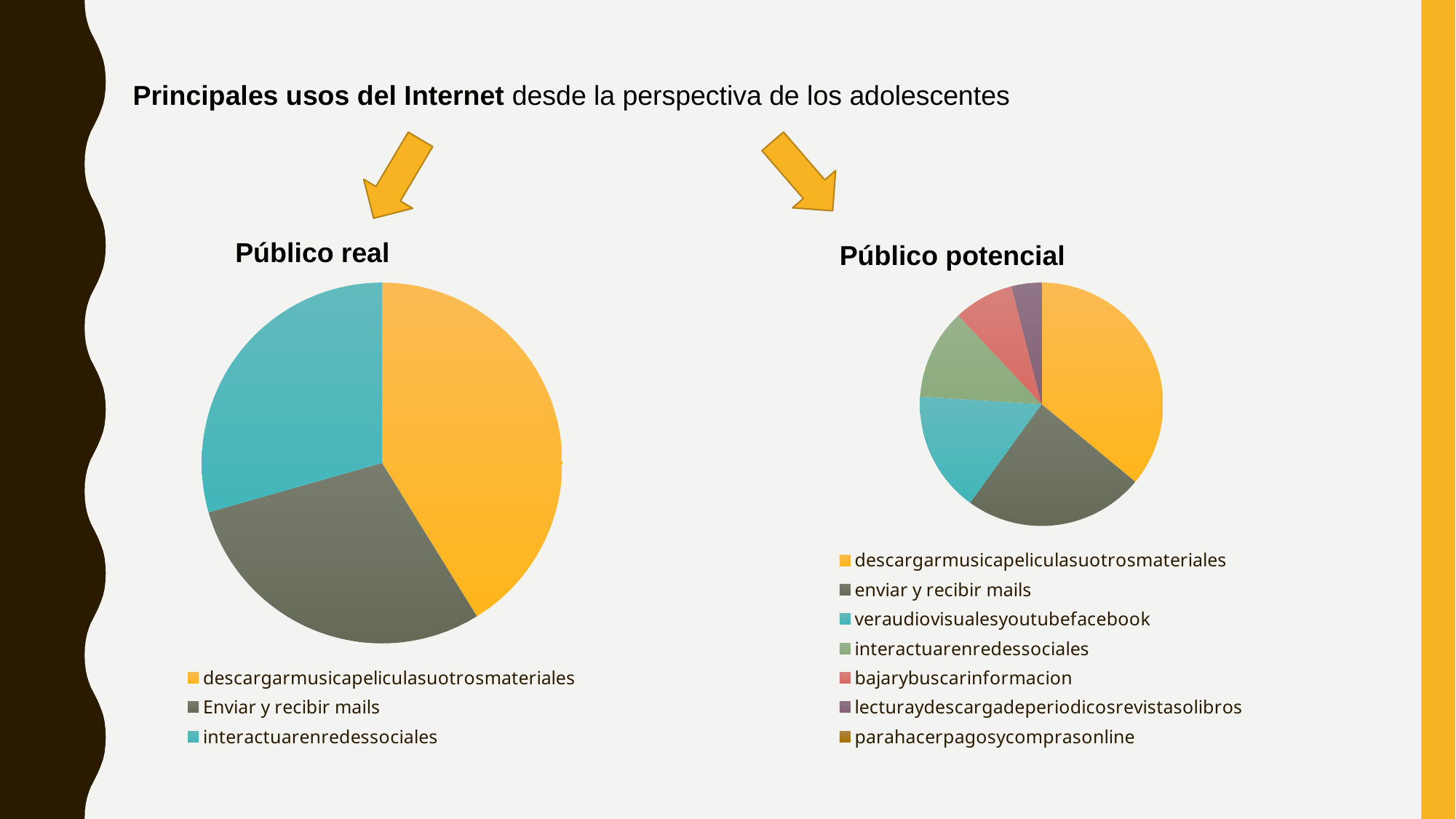
How many categories does the legend of the "Público real" chart list? 3 In the "Público potencial" chart, which slice is larger: descargarmusicapeliculasuotrosmateriales or lecturaydescargadeperiodicosrevistasolibros? descargarmusicapeliculasuotrosmateriales What is the title of the chart on the right side of the slide? Público potencial In the "Público real" chart, which category has the largest slice? descargarmusicapeliculasuotrosmateriales In the "Público real" chart, which slice is larger: descargarmusicapeliculasuotrosmateriales or interactuarenredessociales? descargarmusicapeliculasuotrosmateriales What colour represents "interactuarenredessociales" in the "Público real" chart? teal What kind of chart is the "Público potencial" chart? pie chart How many categories does the legend of the "Público potencial" chart list? 7 In the "Público potencial" chart, which category has the largest slice? descargarmusicapeliculasuotrosmateriales What kind of chart is the "Público real" chart? pie chart In the "Público potencial" chart, which slice is larger: veraudiovisualesyoutubefacebook or bajarybuscarinformacion? veraudiovisualesyoutubefacebook